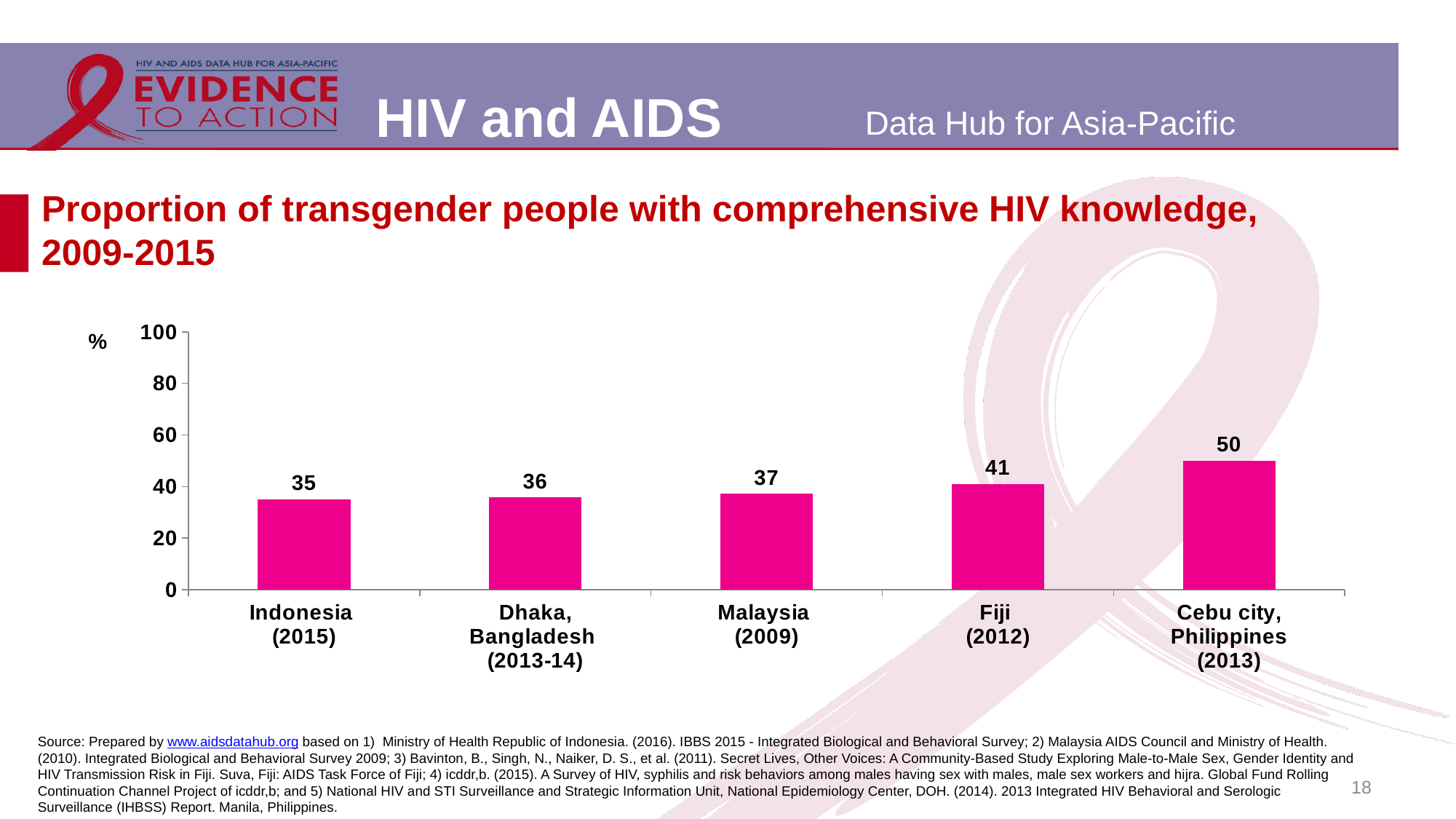
What is the difference between the values for Fiji (2012) and Malaysia (2009)? 4 How many categories are shown in the chart? 5 Which category has the lowest value? Indonesia (2015) Which is larger, the value for Fiji (2012) or the value for Dhaka, Bangladesh (2013-14)? Fiji (2012) What is the value for Cebu city, Philippines (2013)? 50 What is the value for Fiji (2012)? 41 What is the difference between the values for Cebu city, Philippines (2013) and Indonesia (2015)? 15 Which category has the highest value? Cebu city, Philippines (2013) Do the values rise or fall from left to right along the x axis? rise Is the value for Malaysia (2009) greater or less than 40? less What kind of chart is shown on the slide? bar chart What is the value for Indonesia (2015)? 35